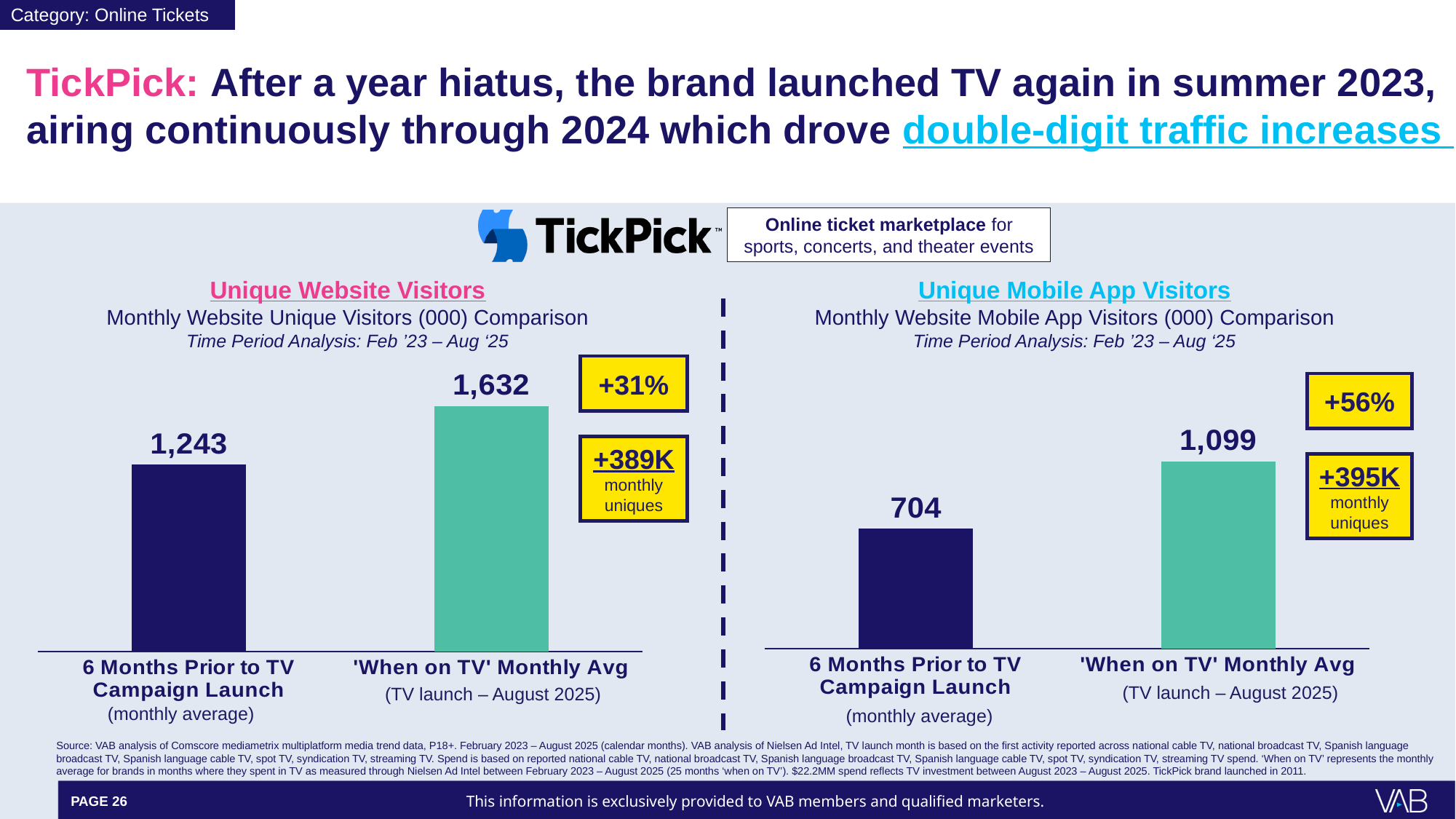
What percentage increase is shown in the callout next to the Unique Mobile App Visitors chart? +56% In the Unique Mobile App Visitors chart, which category has the lower value? 6 Months Prior to TV Campaign Launch In the Unique Website Visitors chart, what is the difference between the 'When on TV' Monthly Avg and the 6 Months Prior value? 389 In the Unique Mobile App Visitors chart, what is the value for 'When on TV' Monthly Avg? 1,099 In the Unique Mobile App Visitors chart, what is the difference between the 'When on TV' Monthly Avg and the 6 Months Prior value? 395 What type of chart is the Unique Website Visitors chart? Bar chart Is the 'When on TV' Monthly Avg value larger in the Unique Website Visitors chart or the Unique Mobile App Visitors chart? Unique Website Visitors How many bars are shown in the Unique Mobile App Visitors chart? 2 In the Unique Website Visitors chart, what is the value for '6 Months Prior to TV Campaign Launch'? 1,243 In the Unique Website Visitors chart, what is the value for 'When on TV' Monthly Avg? 1,632 In the Unique Mobile App Visitors chart, what is the value for '6 Months Prior to TV Campaign Launch'? 704 In the Unique Website Visitors chart, which category has the higher value? 'When on TV' Monthly Avg